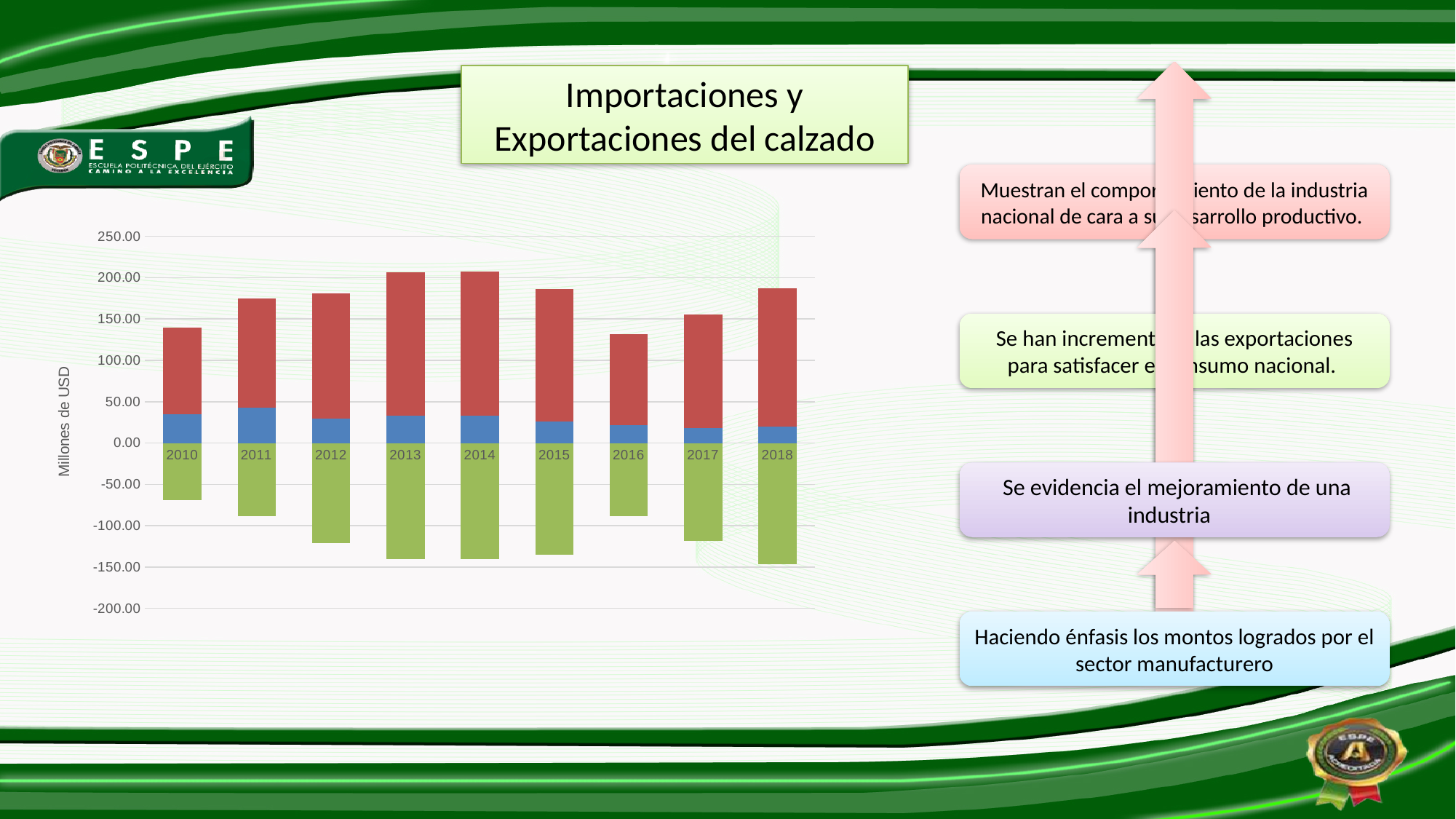
Is the top of the positive stacked bar for 2014 greater or less than 200? greater Is the bottom of the green (negative) bar for 2010 above or below -100? above What kind of chart is shown on the slide? bar chart What is the label of the vertical axis of the chart? Millones de USD What is the title shown above the chart? Importaciones y Exportaciones del calzado Which year has a taller positive stacked bar, 2013 or 2016? 2013 How many years are shown on the x axis of the chart? 9 Is the top of the positive stacked bar for 2010 greater or less than 150? less Do the positive stacked bars rise or fall from 2010 to 2014? rise